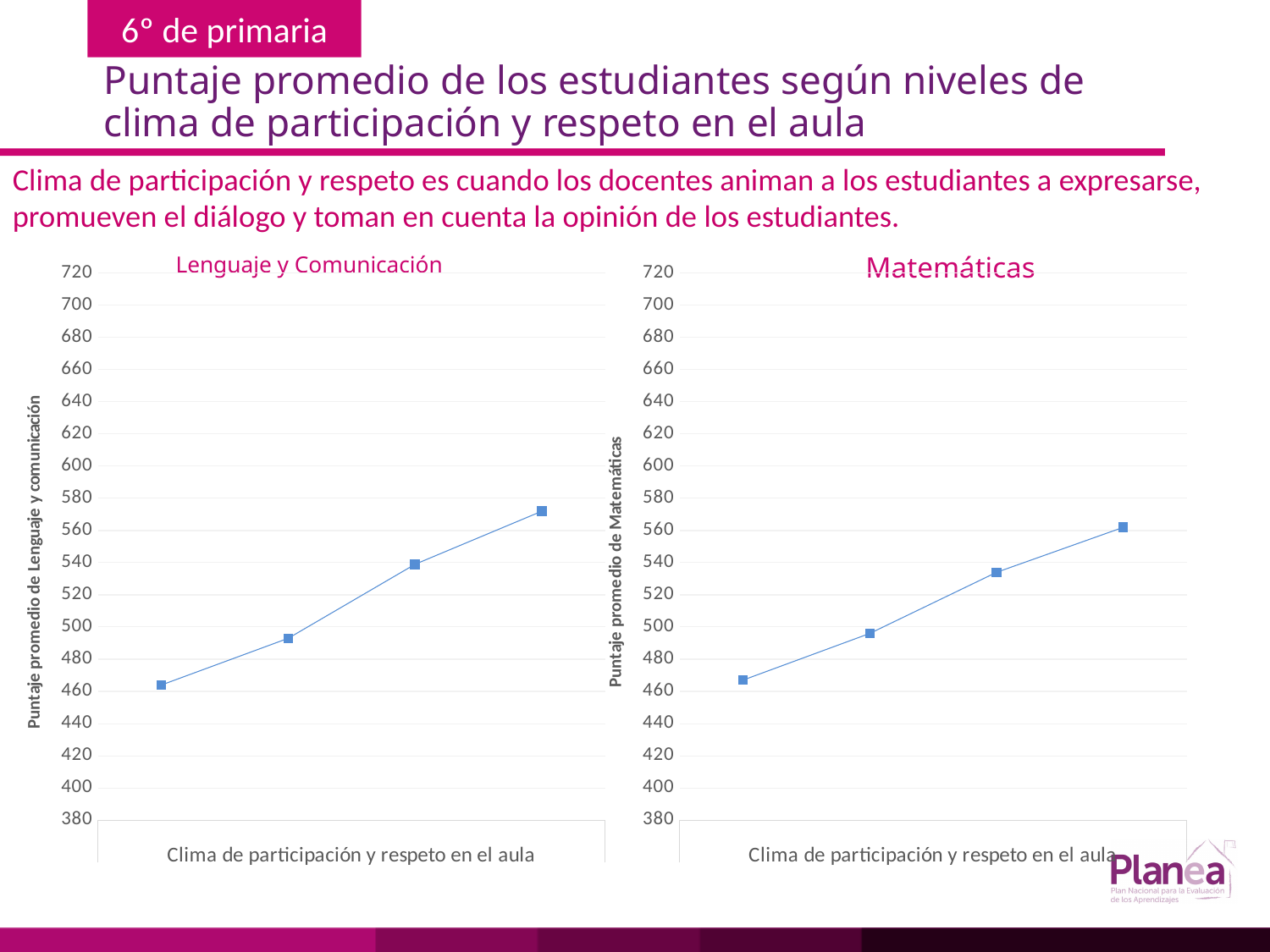
How many data points are plotted in the 'Matemáticas' chart? 4 What is the title of the chart on the right side of the slide? Matemáticas In the 'Matemáticas' chart, is the value of the leftmost point greater or less than 480? less What kind of chart is the 'Lenguaje y Comunicación' chart? line chart In the 'Lenguaje y Comunicación' chart, do the values rise or fall from left to right along the x axis? rise How many data points are plotted in the 'Lenguaje y Comunicación' chart? 4 What kind of chart is the 'Matemáticas' chart? line chart In the 'Matemáticas' chart, is the value of the third point from the left greater or less than 520? greater In the 'Matemáticas' chart, do the values rise or fall from left to right along the x axis? rise In the 'Lenguaje y Comunicación' chart, is the value of the rightmost point greater or less than 560? greater What is the x-axis label of the 'Lenguaje y Comunicación' chart? Clima de participación y respeto en el aula